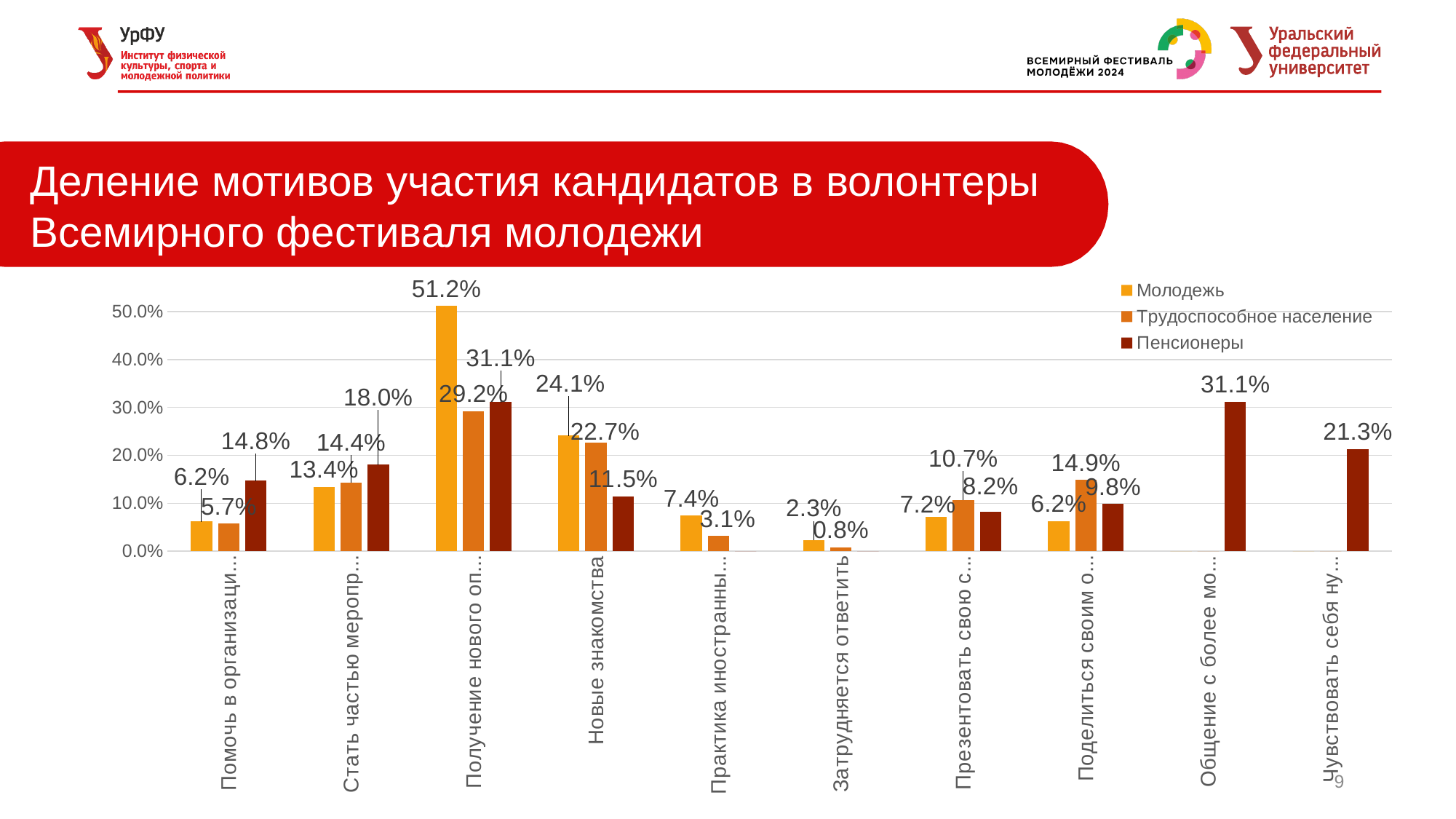
What is the lowest value shown for the Трудоспособное население series? 0.8% How many categories are shown along the x axis of the chart? 10 What is the value for Молодежь in the category Затрудняется ответить? 2.3% What is the highest value shown for the Молодежь series? 51.2% What kind of chart is shown on the slide? Bar chart What is the value for Молодежь in the category Новые знакомства? 24.1% Which series is shown in dark red in the legend? Пенсионеры What is the value for Пенсионеры in the category Новые знакомства? 11.5% In the category Новые знакомства, what is the difference between the Молодежь value and the Пенсионеры value? 12.6 percentage points How many series does the legend list? 3 In the category Новые знакомства, which is larger: the value for Молодежь or for Трудоспособное население? Молодежь What is the value for Трудоспособное население in the category Затрудняется ответить? 0.8%